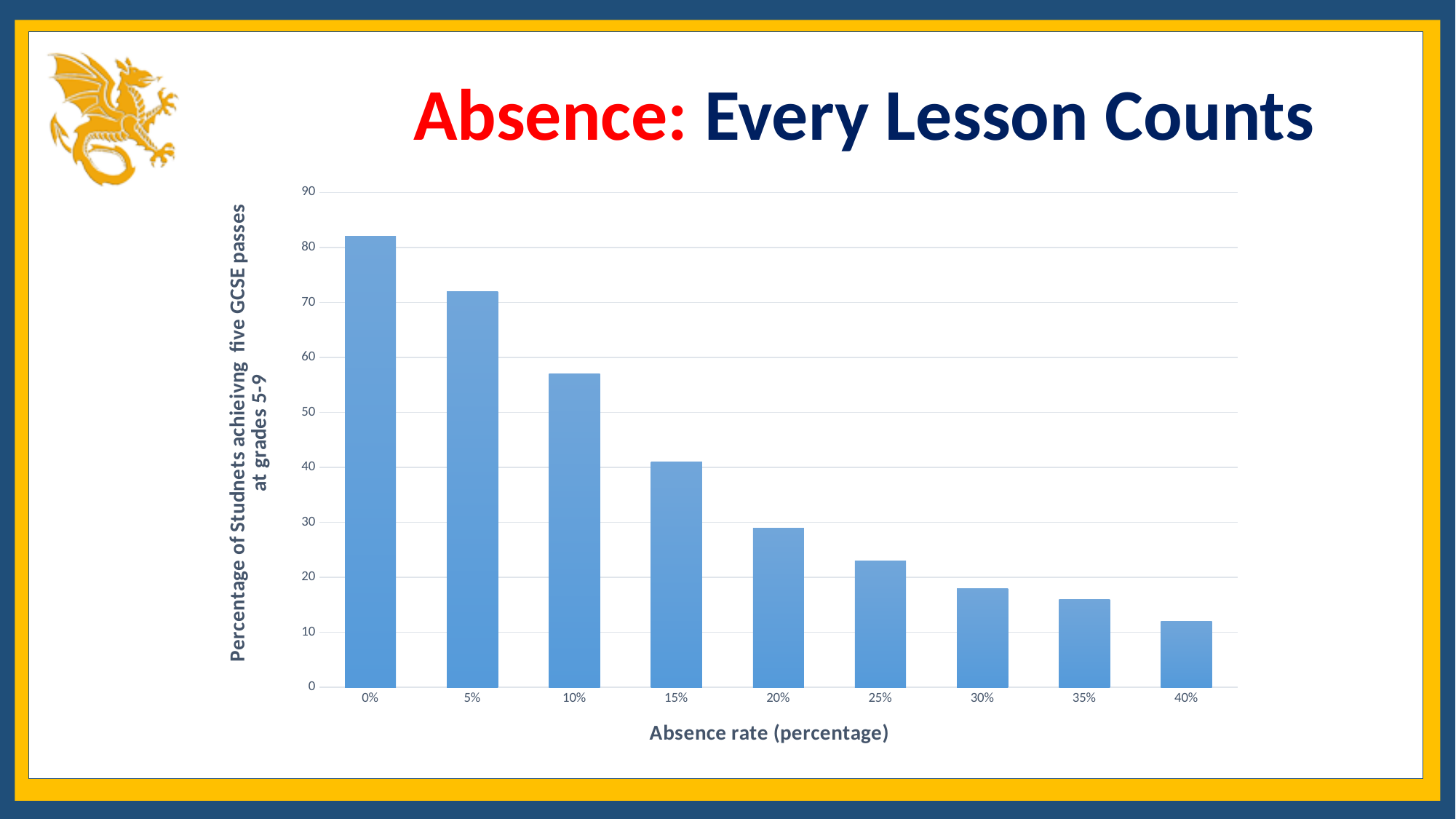
Is the value for the 40% absence rate greater or less than 10? greater Is the value for the 5% absence rate greater or less than 70? greater What is the title of the x axis? Absence rate (percentage) Is the value for the 0% absence rate greater or less than 80? greater Do the values rise or fall as the absence rate increases along the x axis? fall What kind of chart is shown on the slide? bar chart How many absence rate categories are plotted on the x axis? 9 Which absence rate has the lowest percentage of students achieving five GCSE passes at grades 5-9? 40% Which has a higher value, the 10% absence rate or the 25% absence rate? 10% Which absence rate has the highest percentage of students achieving five GCSE passes at grades 5-9? 0%